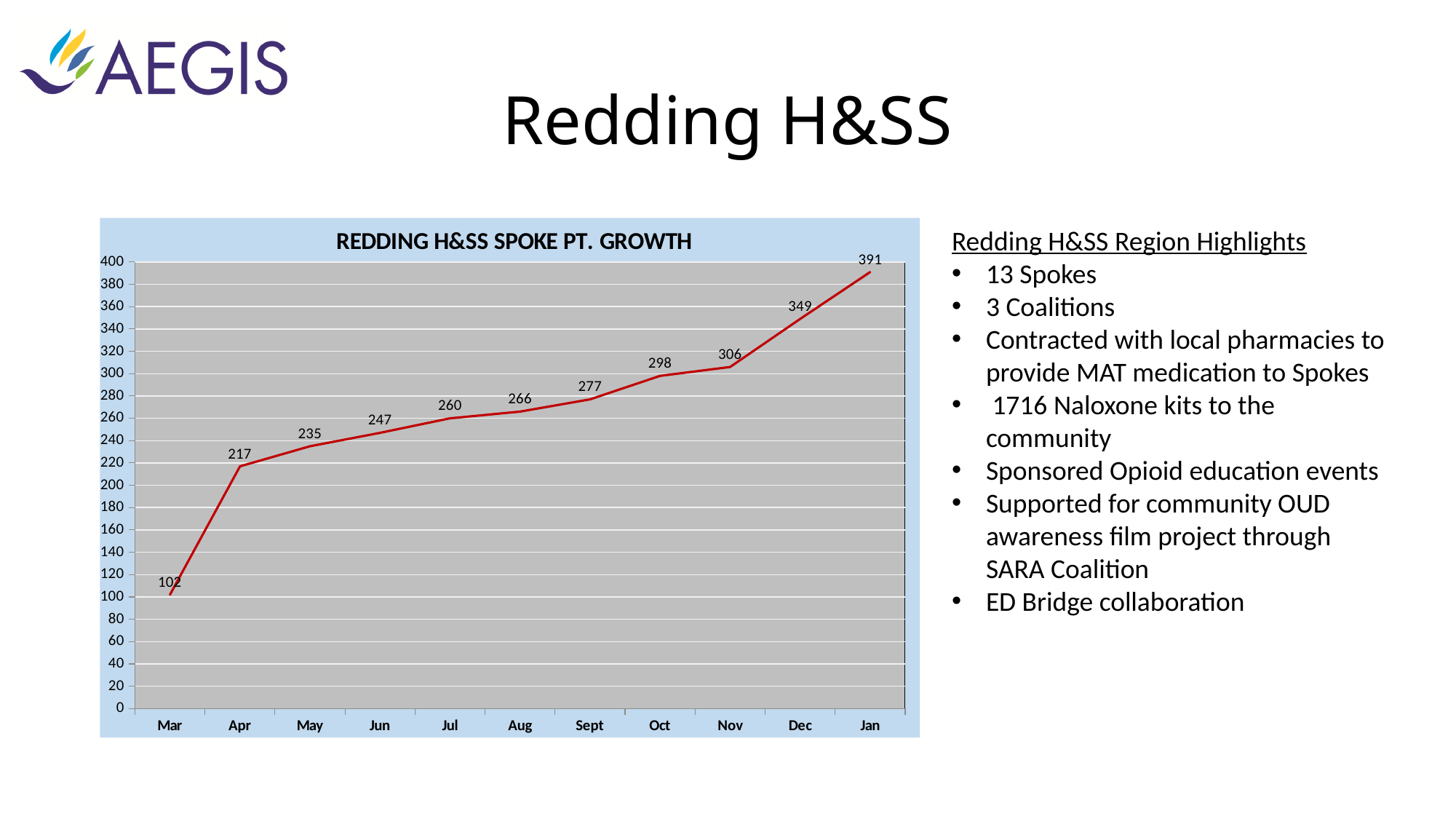
What kind of chart is the Redding H&SS Spoke Pt. Growth chart? line chart Which month has the highest value in the Redding H&SS Spoke Pt. Growth chart? Jan Which is larger in the Redding H&SS Spoke Pt. Growth chart, the value for Apr or the value for Jun? Jun Is the value for Oct in the Redding H&SS Spoke Pt. Growth chart greater or less than 300? less What is the value for Mar in the Redding H&SS Spoke Pt. Growth chart? 102 What is the value for Dec in the Redding H&SS Spoke Pt. Growth chart? 349 How many months are plotted in the Redding H&SS Spoke Pt. Growth chart? 11 Do the values in the Redding H&SS Spoke Pt. Growth chart rise or fall from Mar to Jan? rise What is the difference between the Jan and Mar values in the Redding H&SS Spoke Pt. Growth chart? 289 Which month has the lowest value in the Redding H&SS Spoke Pt. Growth chart? Mar What is the value for Sept in the Redding H&SS Spoke Pt. Growth chart? 277 What is the difference between the Dec and Nov values in the Redding H&SS Spoke Pt. Growth chart? 43